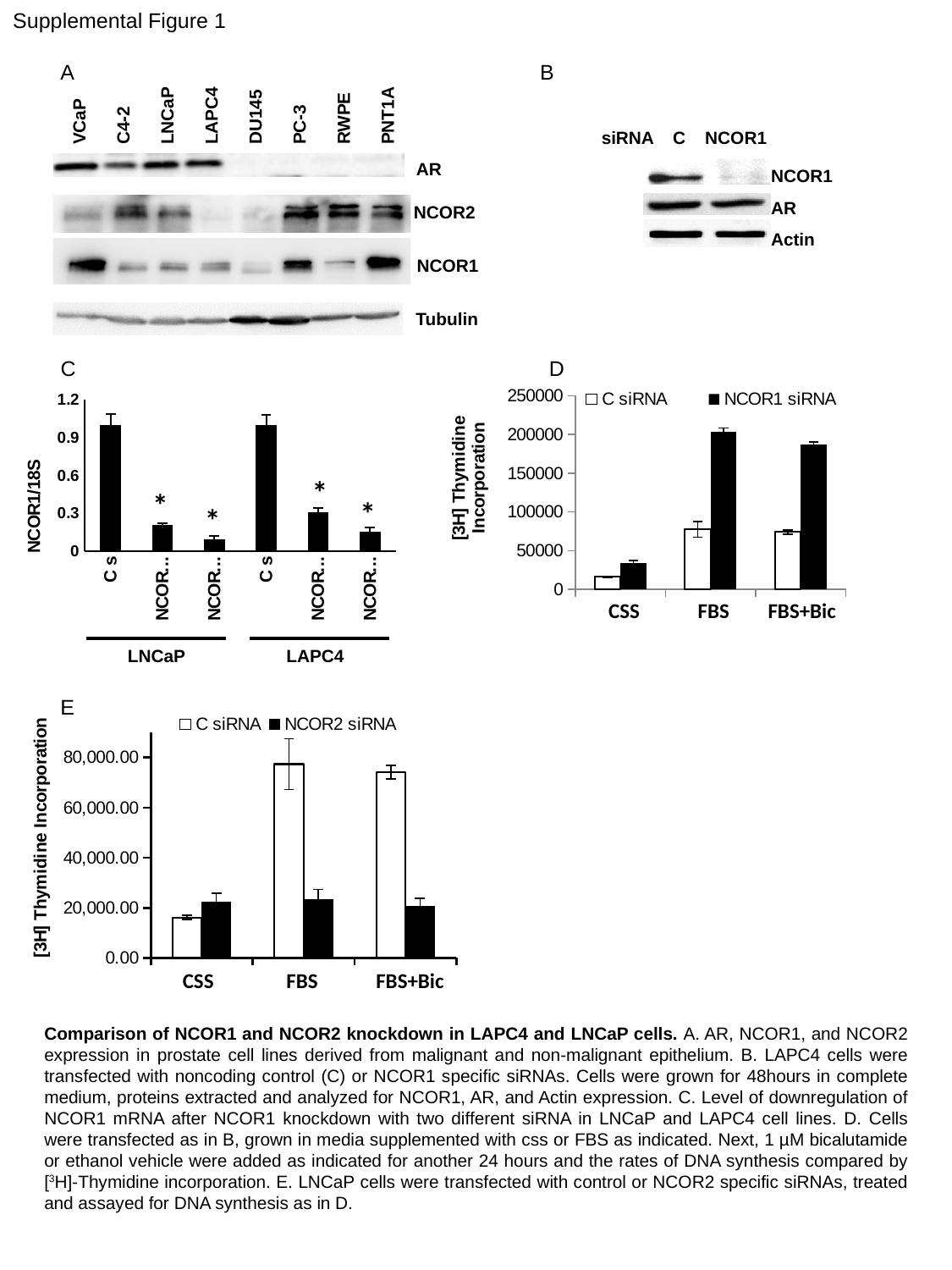
In chart D, which is larger under FBS: C siRNA or NCOR1 siRNA? NCOR1 siRNA In chart E, which series does the black bar represent according to the legend? NCOR2 siRNA In chart D, is the value for NCOR1 siRNA under FBS+Bic greater or less than 150000? greater In chart D, which category has the lowest C siRNA value? CSS In chart C (NCOR1/18S), is the value for the C s bar in LNCaP greater or less than 0.9? greater In chart E, which is larger under FBS+Bic: C siRNA or NCOR2 siRNA? C siRNA In chart E, is the value for C siRNA under FBS greater or less than 60,000.00? greater In chart D, how many series does the legend list? 2 What kind of chart is chart D ([3H] Thymidine Incorporation with C siRNA and NCOR1 siRNA)? bar chart In chart D, how many categories are shown on the x axis? 3